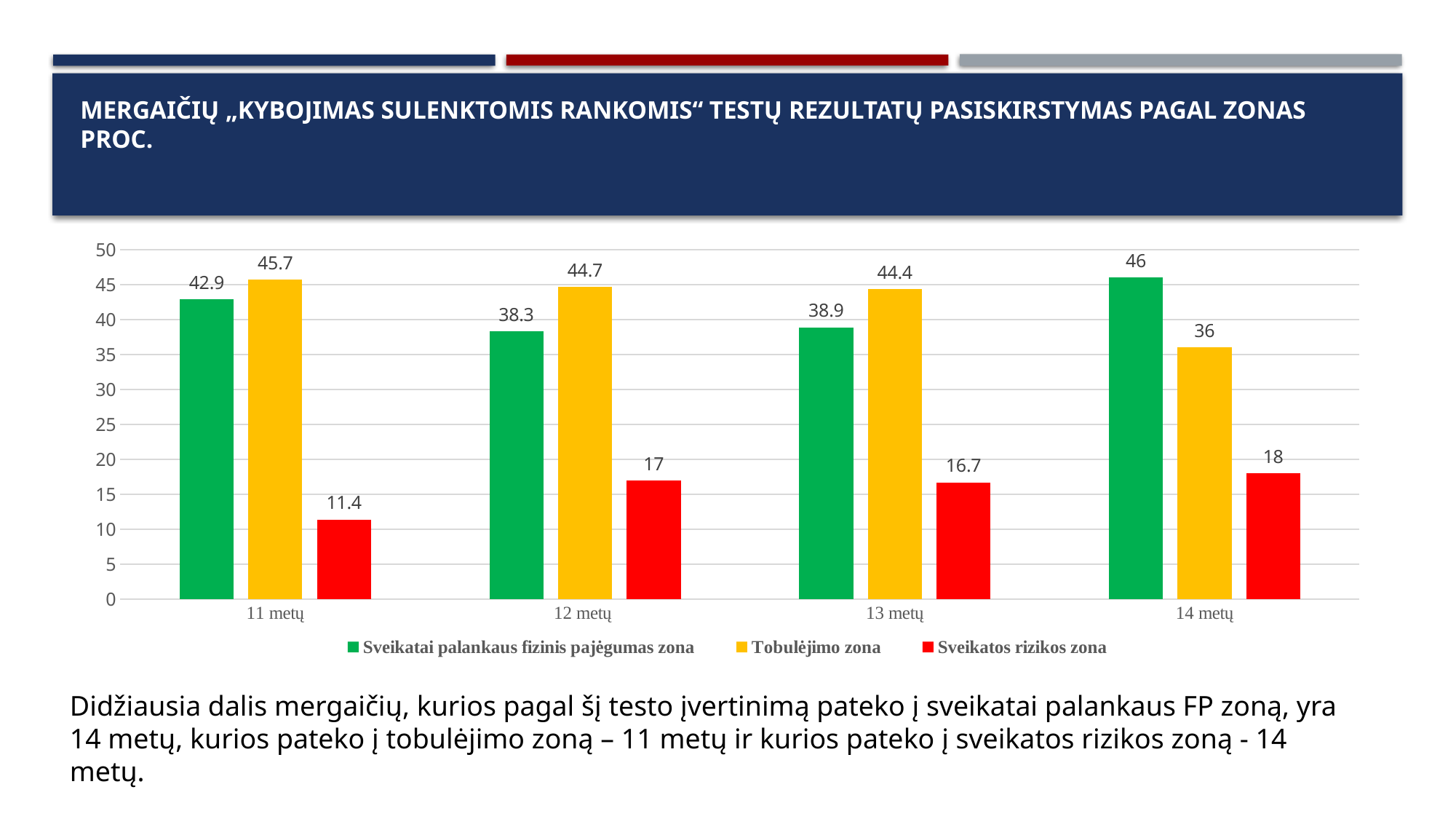
Which colour represents 'Sveikatos rizikos zona' in the chart? red What is the value for 'Tobulėjimo zona' at 13 metų? 44.4 What kind of chart is shown on the slide? bar chart Which is larger at 12 metų: 'Sveikatai palankaus fizinis pajėgumas zona' or 'Tobulėjimo zona'? Tobulėjimo zona What is the difference between the 'Tobulėjimo zona' values at 11 metų and 14 metų? 9.7 How many age groups are shown on the x axis? 4 Is the value for 'Sveikatos rizikos zona' at 14 metų greater or less than 20? less Which age group has the lowest value for 'Sveikatos rizikos zona'? 11 metų What is the value for 'Sveikatai palankaus fizinis pajėgumas zona' at 11 metų? 42.9 Which age group has the highest value for 'Sveikatai palankaus fizinis pajėgumas zona'? 14 metų What is the value for 'Sveikatos rizikos zona' at 12 metų? 17 How many series does the legend list? 3